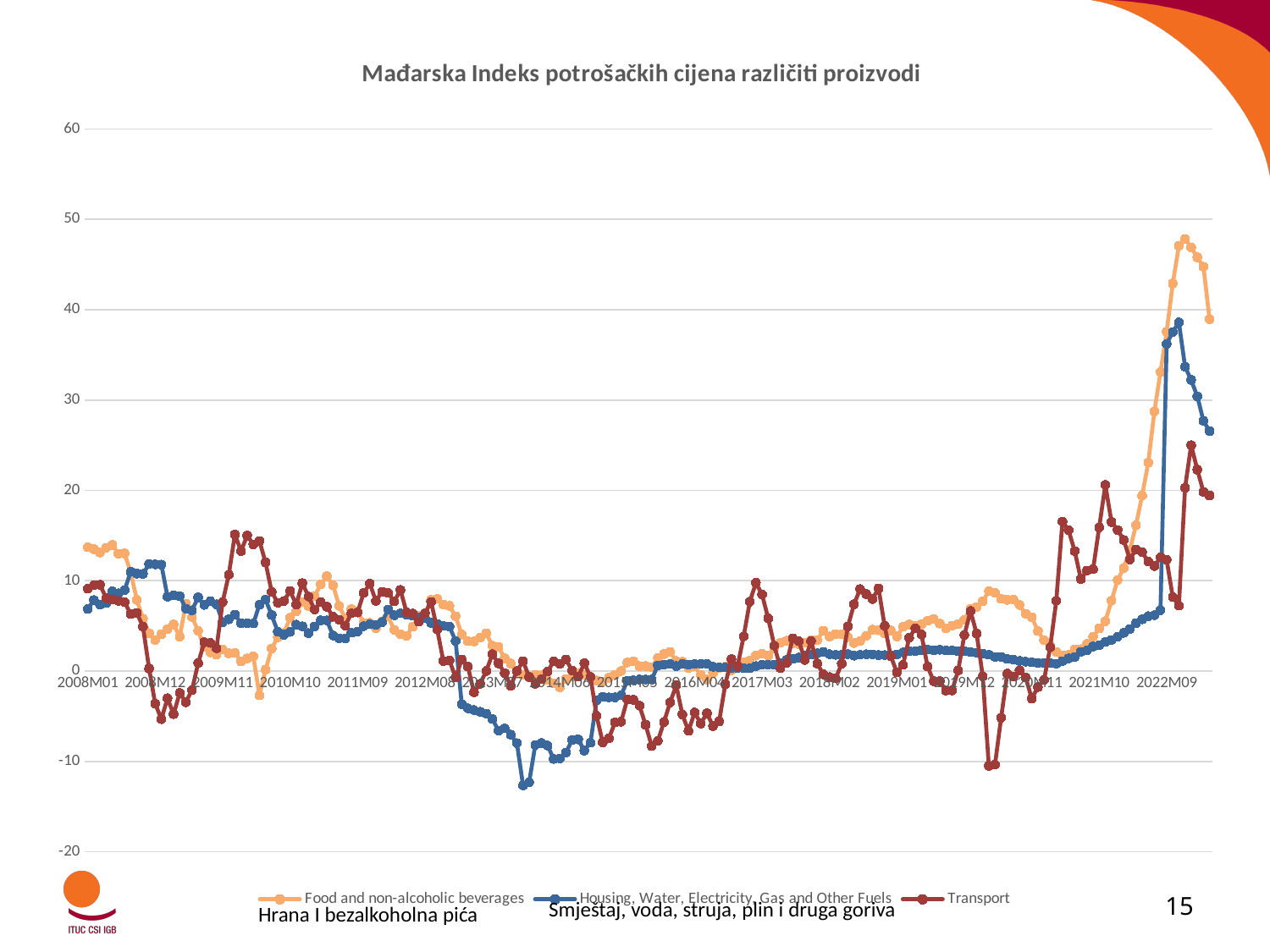
Is the peak value of the Food and non-alcoholic beverages series greater or less than 40? greater Which series reaches the highest peak on the chart? Food and non-alcoholic beverages Which series reaches the lowest value on the chart? Housing, Water, Electricity, Gas and Other Fuels Is the lowest value of the Housing, Water, Electricity, Gas and Other Fuels series greater or less than -10? less Is the peak value of the Transport series greater or less than 30? less What kind of chart is shown on the slide? line chart What is the title of the chart? Mađarska Indeks potrošačkih cijena različiti proizvodi What colour is the Transport line on the chart? dark red At the last plotted point on the right of the chart, which series has the highest value? Food and non-alcoholic beverages Does the Food and non-alcoholic beverages series rise or fall between 2021M10 and its peak in 2022? rise How many series does the legend list? 3